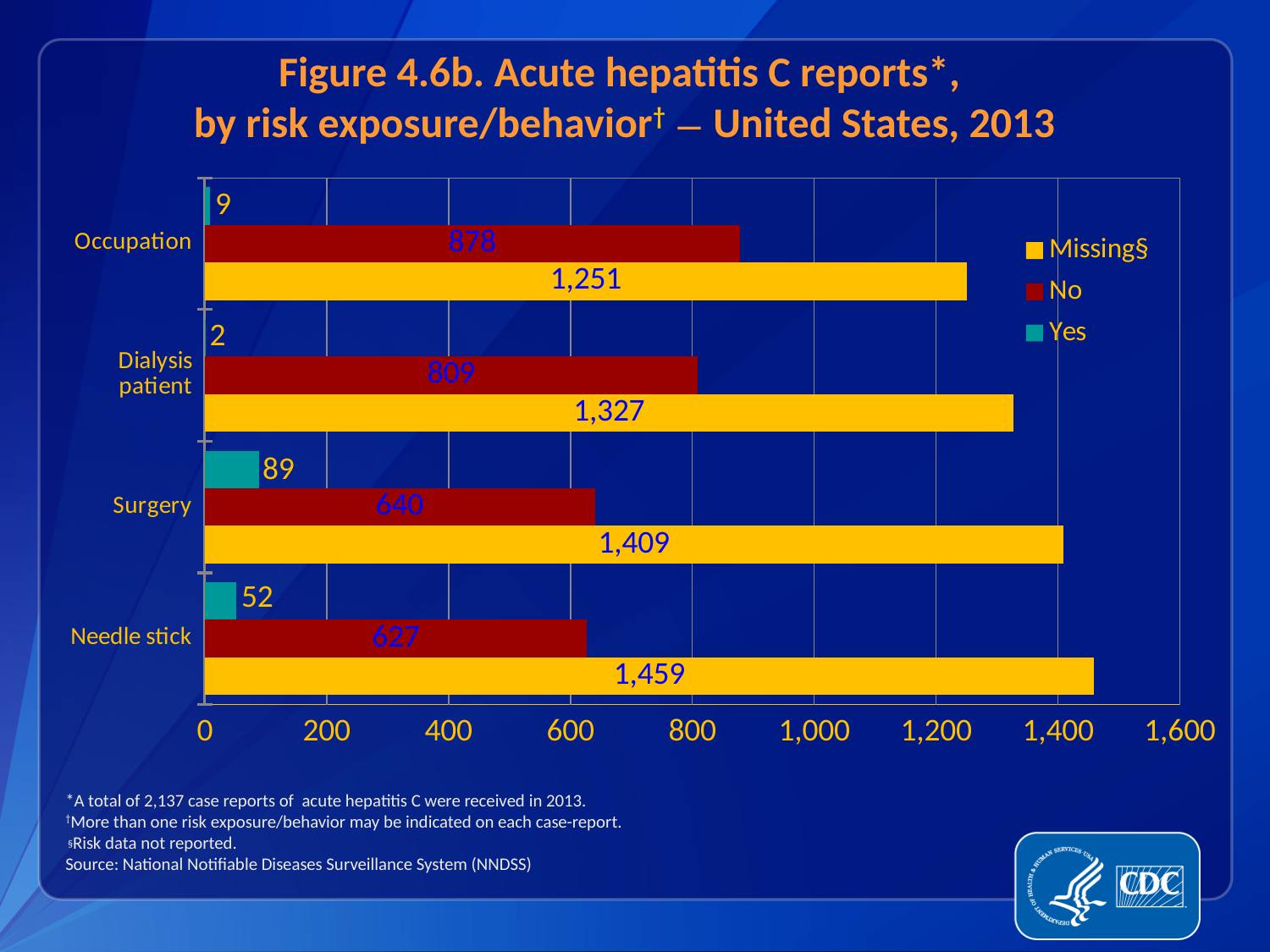
Which category has the lowest Yes value? Dialysis patient What is the value for Yes in the Dialysis patient category? 2 What is the value for Yes in the Surgery category? 89 What is the value for No in the Occupation category? 878 Is the No value for Dialysis patient greater or less than 1,000? less Which category has the highest Missing value? Needle stick What is the value for Missing in the Needle stick category? 1,459 How many series does the legend list? 3 How many risk exposure/behavior categories are shown on the chart? 4 Which is larger, the Missing value for Surgery or the Missing value for Dialysis patient? Surgery What is the difference between the No values for Occupation and Needle stick? 251 What kind of chart is shown on the slide? bar chart